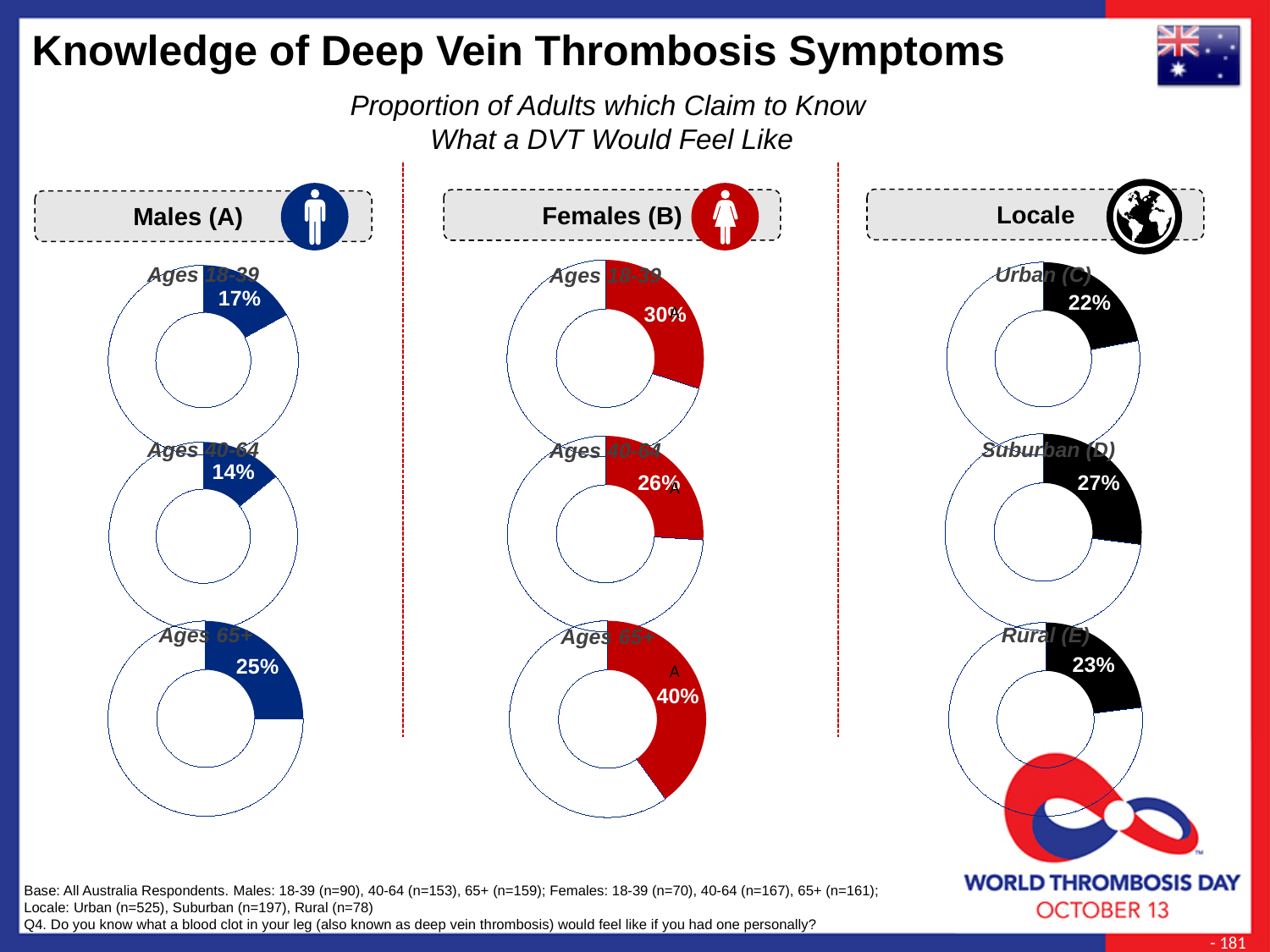
Among the three Males (A) donut charts, which age group has the highest proportion? Ages 65+ In the Locale Suburban (D) donut chart, what proportion of adults claim to know what a DVT would feel like? 27% Among the three Locale donut charts, which locale has the highest proportion? Suburban (D) In the Males (A) Ages 18-39 donut chart, what proportion of adults claim to know what a DVT would feel like? 17% Among the three Males (A) donut charts, which age group has the lowest proportion? Ages 40-64 What is the difference between the Locale Suburban (D) value and the Locale Rural (E) value? 4% In the Females (B) Ages 65+ donut chart, what proportion of adults claim to know what a DVT would feel like? 40% What is the difference between the Females (B) Ages 65+ value and the Males (A) Ages 65+ value? 15% How many donut charts are shown on the slide in total? 9 What type of chart is used to show the Males (A) Ages 40-64 proportion? Donut chart Among the three Females (B) donut charts, which age group has the lowest proportion? Ages 40-64 Which is larger: the Females (B) Ages 18-39 value or the Locale Urban (C) value? Females (B) Ages 18-39